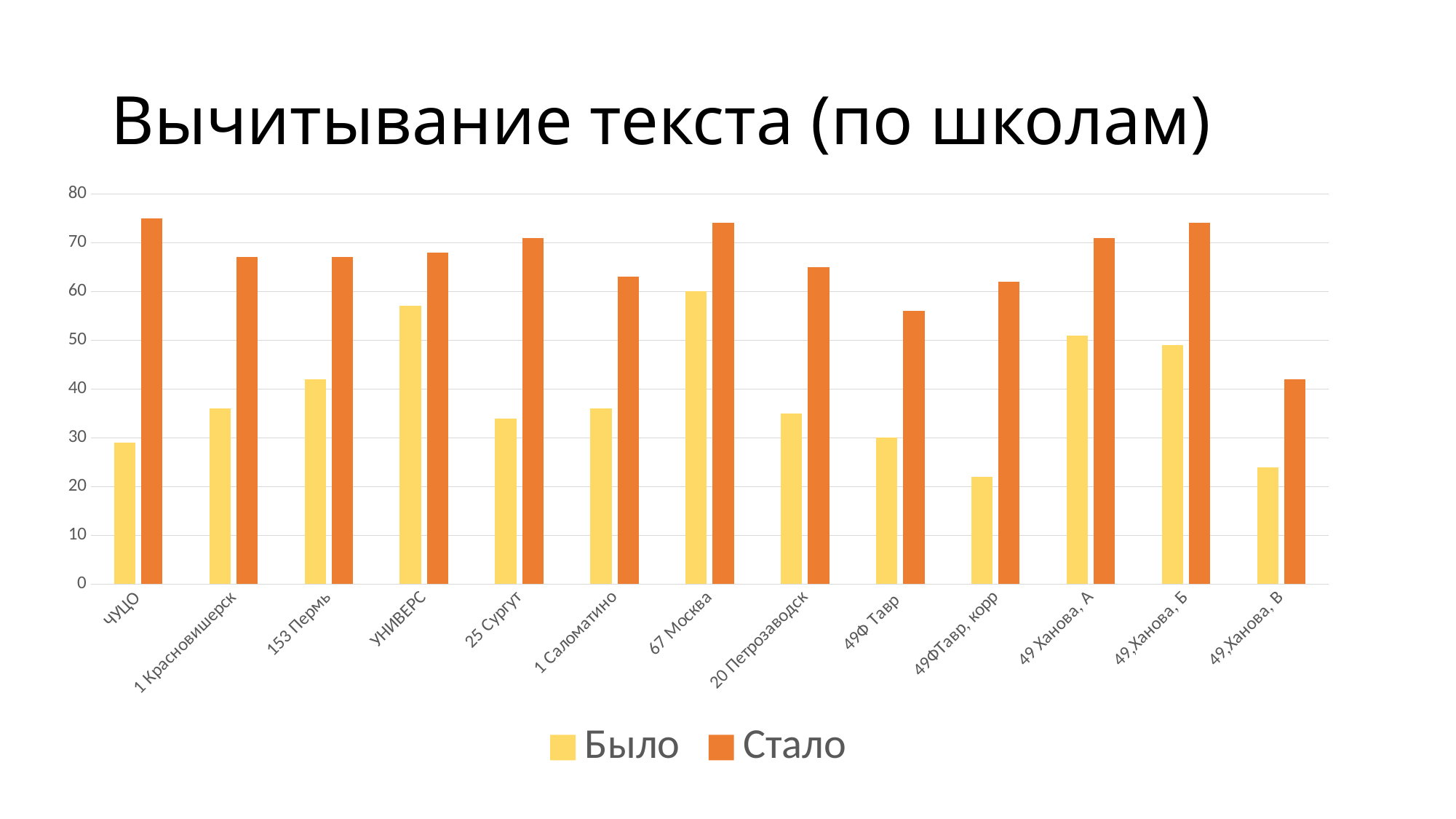
What is the title of the chart? Вычитывание текста (по школам) Which school has the lowest value for Стало? 49,Ханова, В Is the value for Было for 49ФТавр, корр greater or less than 30? less What kind of chart is shown on the slide? bar chart Is the value for Стало for ЧУЦО greater or less than 70? greater Is the value for Было for УНИВЕРС greater or less than 50? greater For 1 Красновишерск, which is larger: Было or Стало? Стало Which series is shown in orange? Стало Which has the larger Было value: 67 Москва or ЧУЦО? 67 Москва How many schools (categories) are shown on the x axis? 13 How many series does the legend list? 2